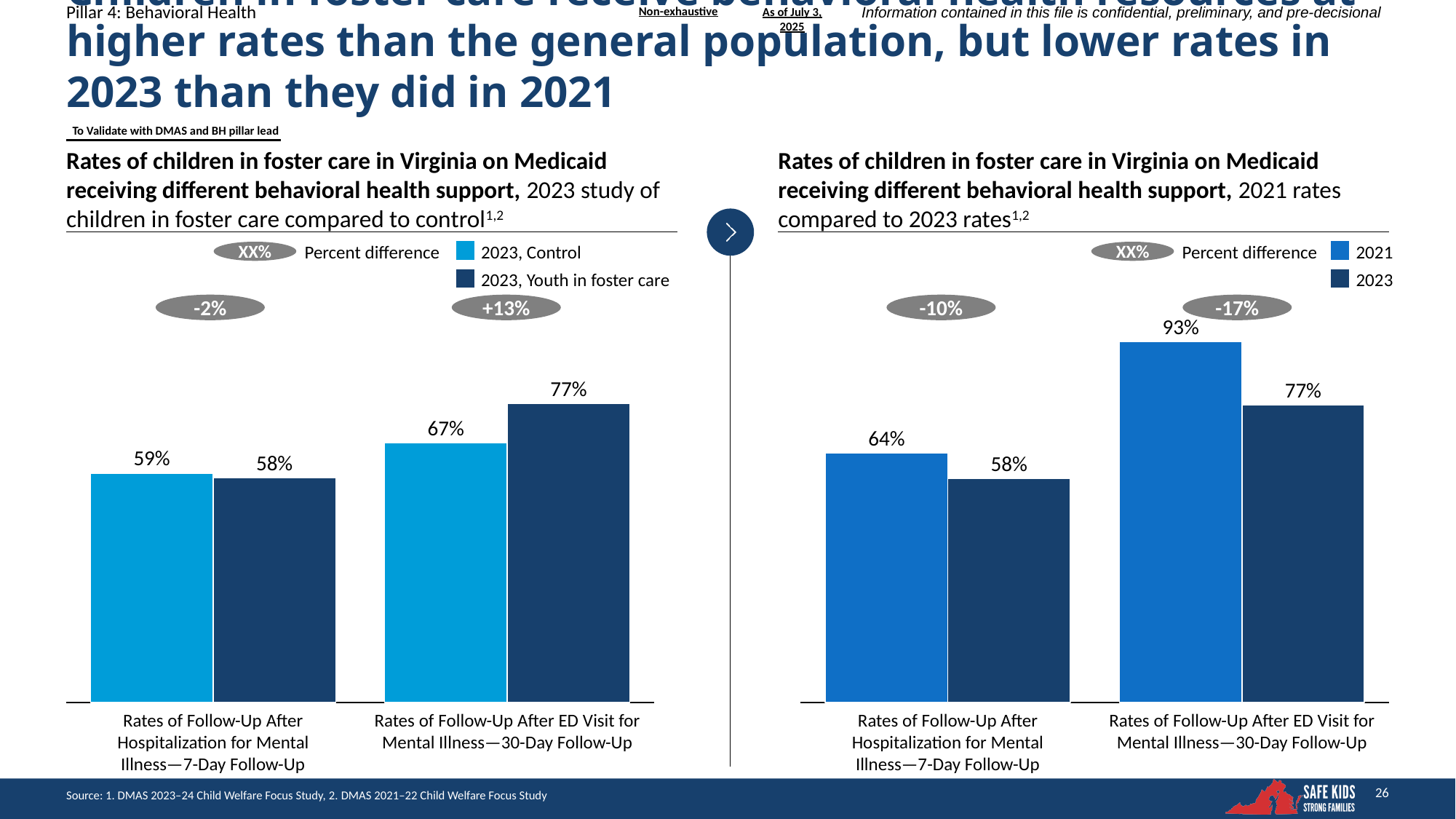
In the right chart (2021 rates compared to 2023 rates), what is the difference between the 2021 and 2023 values for the 30-Day Follow-Up category? 16% How many series does the legend of the right chart (2021 rates compared to 2023 rates) list? 2 In the right chart (2021 rates compared to 2023 rates), what is the 2021 value for Rates of Follow-Up After ED Visit for Mental Illness—30-Day Follow-Up? 93% In the left chart (2023 study compared to control), what is the value for 2023, Control for Rates of Follow-Up After Hospitalization for Mental Illness—7-Day Follow-Up? 59% In the left chart (2023 study compared to control), which is larger for the 30-Day Follow-Up category: 2023, Control or 2023, Youth in foster care? 2023, Youth in foster care In the left chart (2023 study compared to control), what is the value for 2023, Youth in foster care for Rates of Follow-Up After ED Visit for Mental Illness—30-Day Follow-Up? 77% In the left chart (2023 study compared to control), what percent difference is shown above the 30-Day Follow-Up category? +13% In the left chart (2023 study compared to control), what is the difference between the 2023, Youth in foster care value and the 2023, Control value for the 30-Day Follow-Up category? 10% In the right chart (2021 rates compared to 2023 rates), what is the 2023 value for Rates of Follow-Up After Hospitalization for Mental Illness—7-Day Follow-Up? 58% In the right chart (2021 rates compared to 2023 rates), which is larger for the 7-Day Follow-Up category: 2021 or 2023? 2021 In the right chart (2021 rates compared to 2023 rates), which bar is the highest? 2021, Rates of Follow-Up After ED Visit for Mental Illness—30-Day Follow-Up What kind of chart is the left chart (2023 study compared to control)? Bar chart